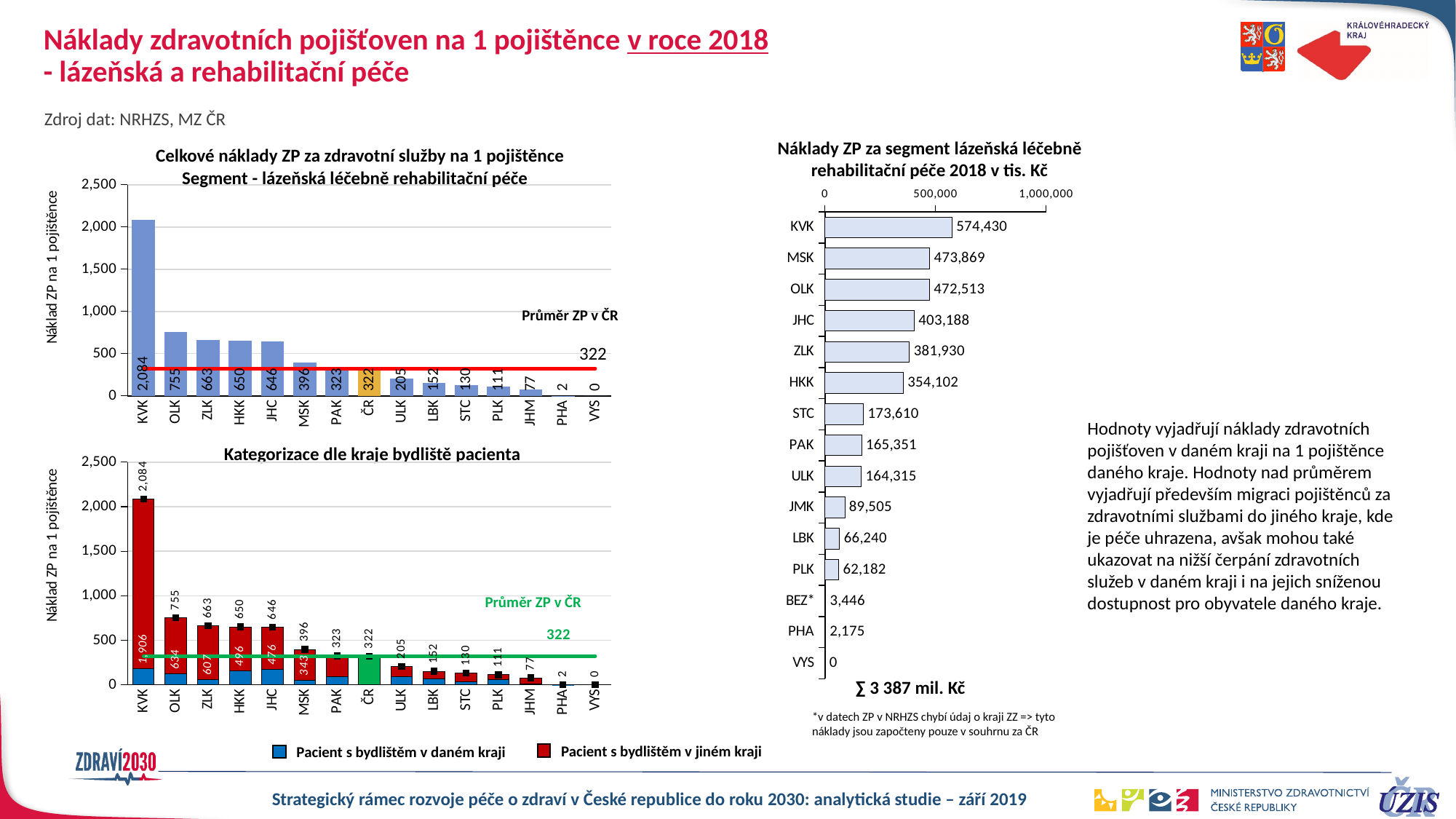
What kind of chart is the right-hand chart 'Náklady ZP za segment lázeňská léčebně rehabilitační péče 2018 v tis. Kč'? Bar chart In the right-hand chart 'Náklady ZP za segment lázeňská léčebně rehabilitační péče 2018 v tis. Kč', what is the value for JHC? 403,188 In the top-left chart 'Celkové náklady ZP za zdravotní služby na 1 pojištěnce', what is the value of the 'Průměr ZP v ČR' line? 322 In the right-hand chart 'Náklady ZP za segment lázeňská léčebně rehabilitační péče 2018 v tis. Kč', which is larger, MSK or OLK? MSK In the bottom-left chart 'Kategorizace dle kraje bydliště pacienta', what is the value of the 'Pacient s bydlištěm v jiném kraji' segment for KVK? 1,906 In the bottom-left chart 'Kategorizace dle kraje bydliště pacienta', how many series does the legend list? 2 In the right-hand chart 'Náklady ZP za segment lázeňská léčebně rehabilitační péče 2018 v tis. Kč', what is the sum shown below the bars? ∑ 3 387 mil. Kč In the top-left chart 'Celkové náklady ZP za zdravotní služby na 1 pojištěnce', what is the value for KVK? 2,084 In the top-left chart 'Celkové náklady ZP za zdravotní služby na 1 pojištěnce', what is the difference between the values for OLK and ZLK? 92 In the top-left chart 'Celkové náklady ZP za zdravotní služby na 1 pojištěnce', which region has the highest value? KVK In the top-left chart 'Celkové náklady ZP za zdravotní služby na 1 pojištěnce', how many regions (categories) are shown on the x axis? 15 In the bottom-left chart 'Kategorizace dle kraje bydliště pacienta', what is the total of the stacked bar for OLK? 755